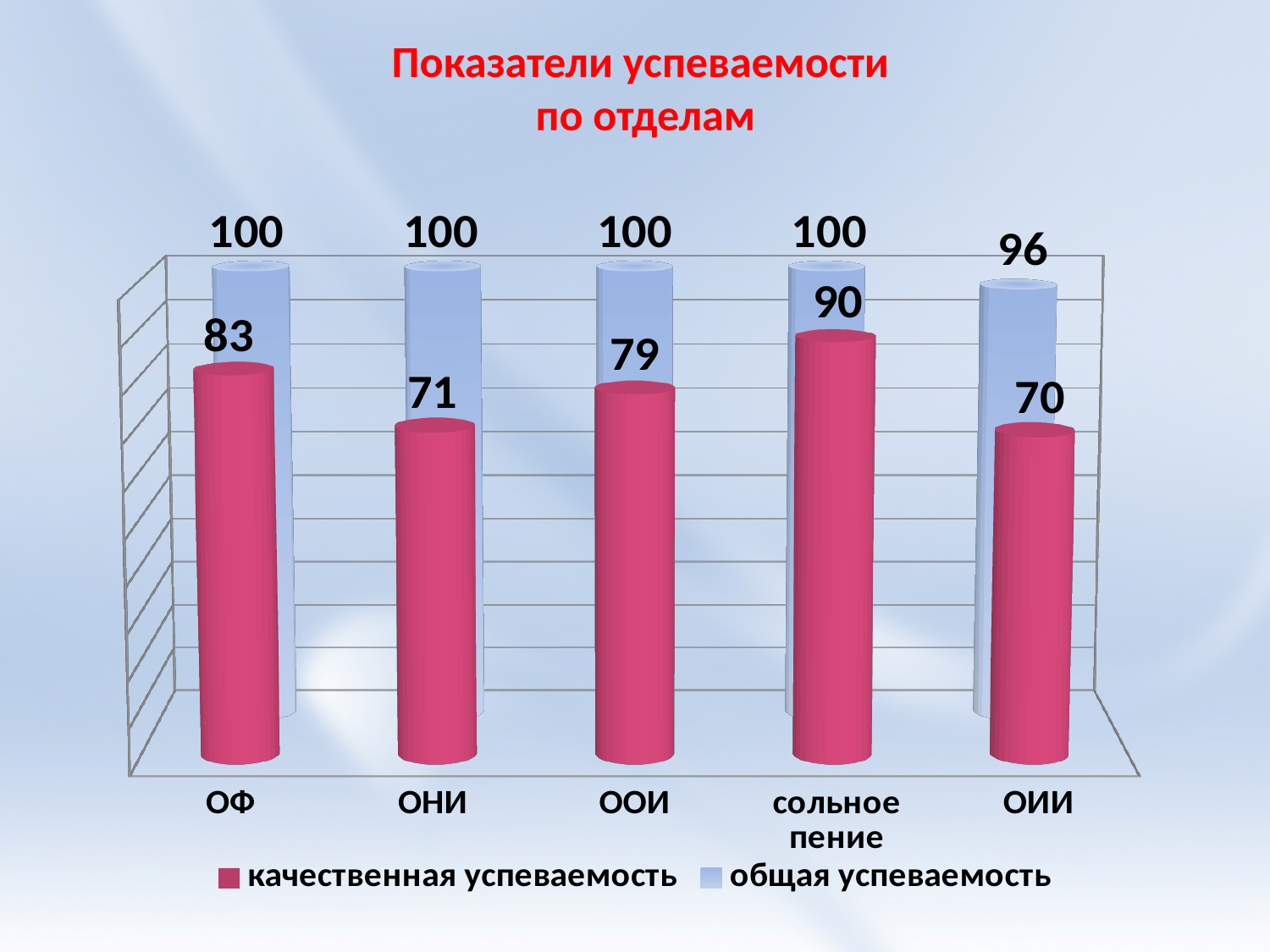
What is the value of качественная успеваемость for сольное пение? 90 What kind of chart is shown on the slide? bar chart Which is larger: качественная успеваемость for ООИ or for ОФ? ОФ How many series does the legend list? 2 How many categories are shown on the x axis? 5 What is the title of the chart? Показатели успеваемости по отделам Which category has the lowest качественная успеваемость? ОИИ Which category has the highest качественная успеваемость? сольное пение What is the value of общая успеваемость for ОИИ? 96 What is the difference between общая успеваемость and качественная успеваемость for ОНИ? 29 Which category has the lowest общая успеваемость? ОИИ What is the value of качественная успеваемость for ОФ? 83